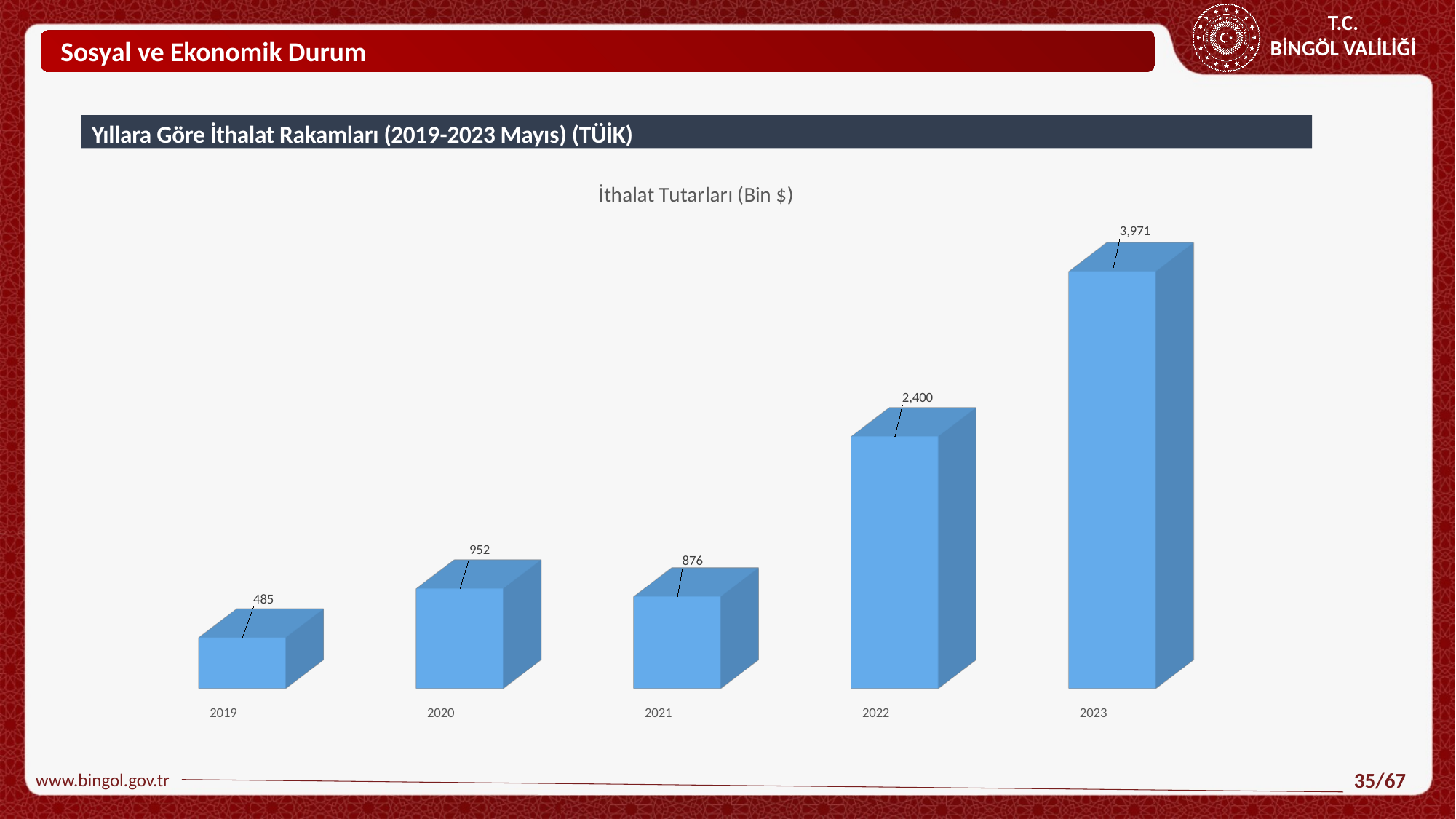
Which year has the lowest value? 2019 What is the title of the chart? İthalat Tutarları (Bin $) What is the difference between the values for 2020 and 2021? 76 Which is larger, the value for 2020 or the value for 2021? 2020 What kind of chart is this? Bar chart Which year has the highest value? 2023 What is the value for 2019? 485 Do the values generally rise or fall from 2019 to 2023? Rise What is the difference between the values for 2023 and 2022? 1,571 What is the value for 2022? 2,400 What is the value for 2023? 3,971 How many years are shown on the chart? 5